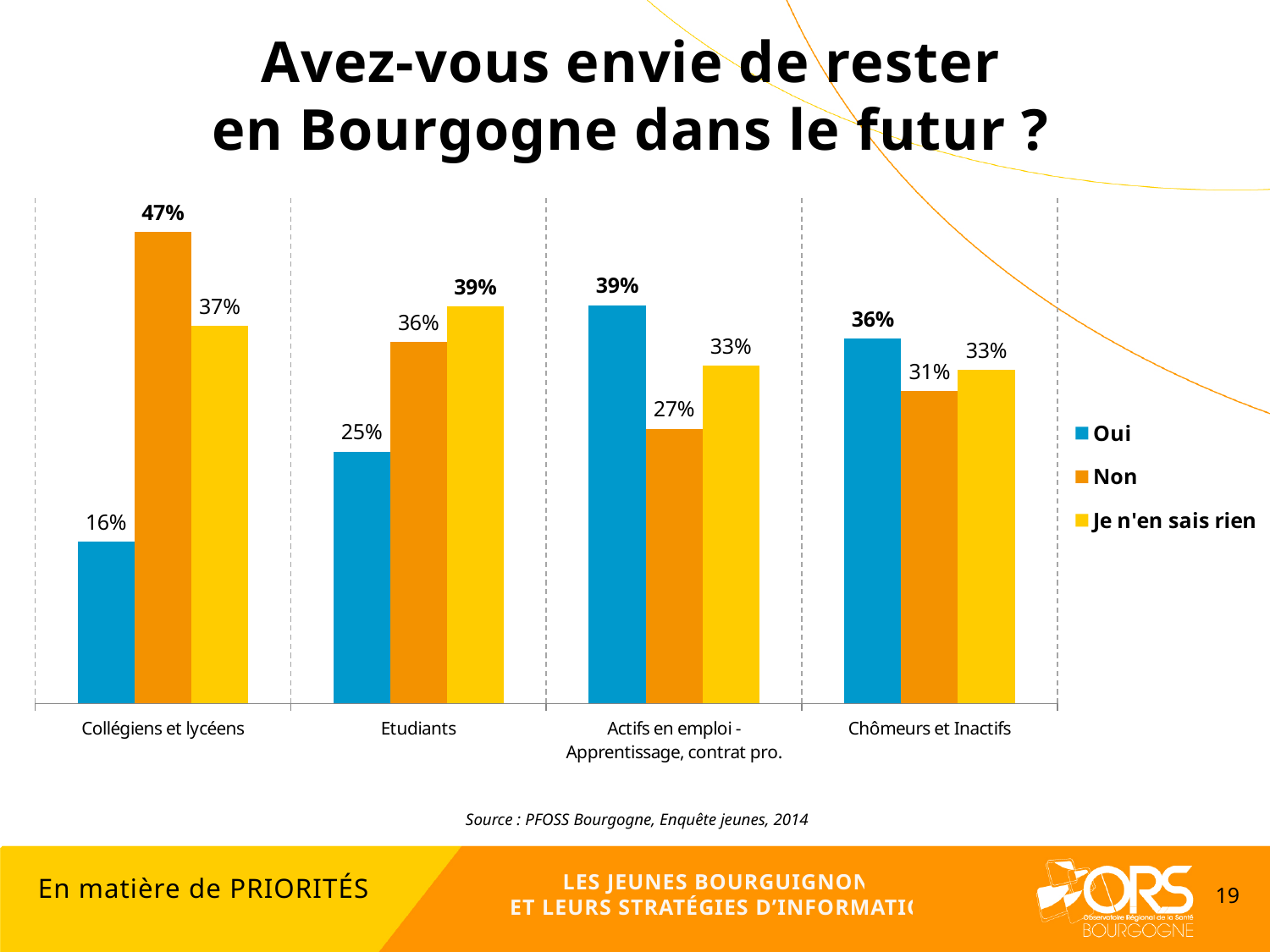
What is the "Oui" value for Etudiants? 25% Which category has the lowest "Oui" value? Collégiens et lycéens For Actifs en emploi - Apprentissage, contrat pro., which is larger: "Oui" or "Non"? Oui What percentage of Chômeurs et Inactifs answered "Je n'en sais rien"? 33% What kind of chart is shown on the slide? Bar chart Which category has the highest "Oui" value? Actifs en emploi - Apprentissage, contrat pro. Does the "Oui" value rise or fall from Collégiens et lycéens to Actifs en emploi - Apprentissage, contrat pro.? Rise How many categories are shown on the x axis? 4 What percentage of Collégiens et lycéens answered "Non"? 47% Which colour represents the "Non" series in the legend? Orange What is the difference between the "Non" and "Oui" values for Collégiens et lycéens? 31% How many series does the legend list? 3